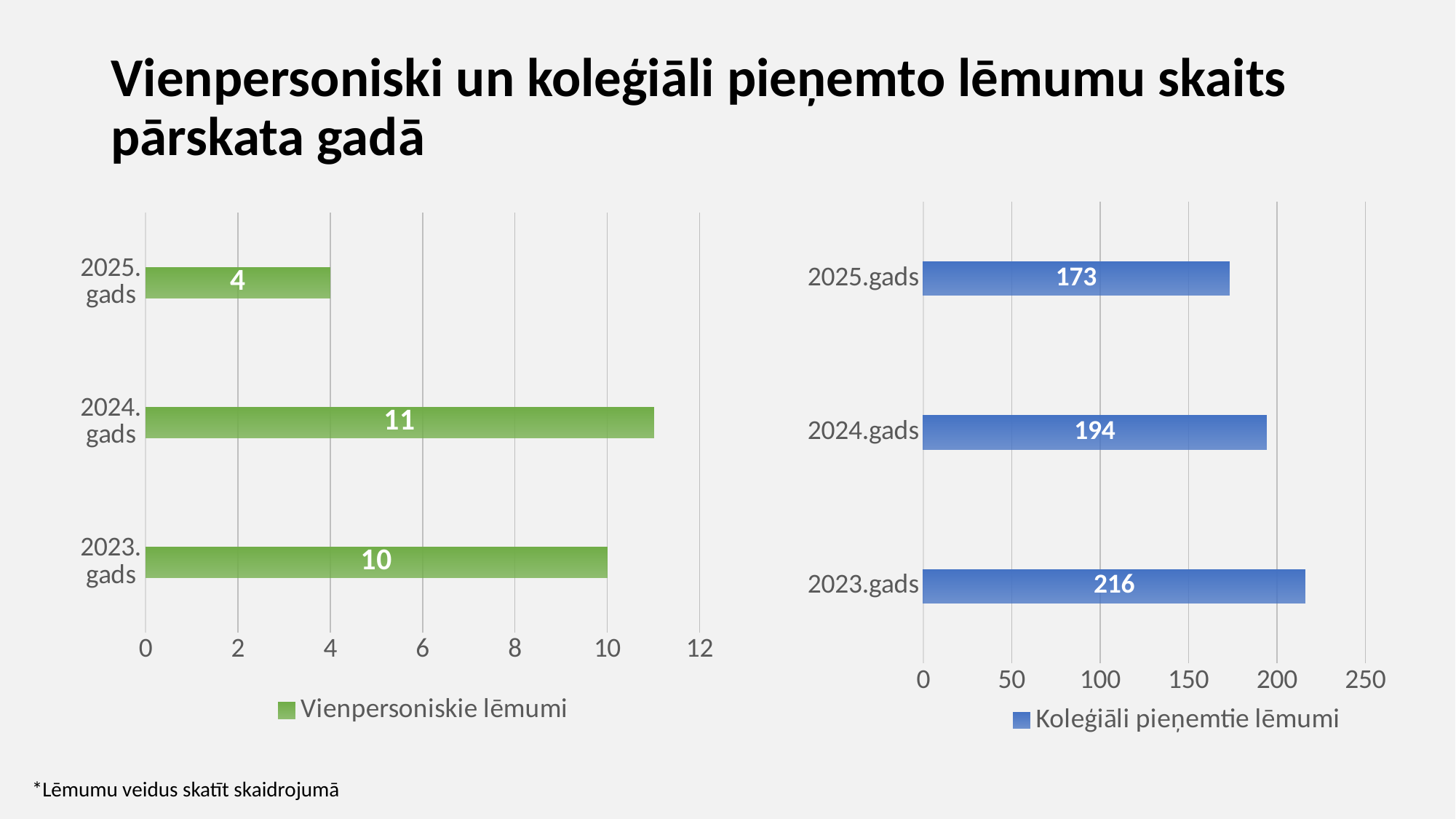
In the right chart (Koleģiāli pieņemtie lēmumi), which year has the lowest value? 2025.gads In the right chart (Koleģiāli pieņemtie lēmumi), is the value for 2024.gads greater or less than 150? greater In the left chart (Vienpersoniskie lēmumi), what is the value for 2024. gads? 11 In the left chart (Vienpersoniskie lēmumi), which year has the highest value? 2024. gads In the right chart (Koleģiāli pieņemtie lēmumi), what is the value for 2025.gads? 173 In the left chart (Vienpersoniskie lēmumi), what is the difference between the values for 2024. gads and 2025. gads? 7 In the right chart (Koleģiāli pieņemtie lēmumi), what is the value for 2023.gads? 216 In the right chart (Koleģiāli pieņemtie lēmumi), which is larger: the value for 2024.gads or 2025.gads? 2024.gads In the right chart (Koleģiāli pieņemtie lēmumi), what is the difference between the values for 2023.gads and 2024.gads? 22 How many years are shown in the left chart (Vienpersoniskie lēmumi)? 3 What kind of chart is the right chart (Koleģiāli pieņemtie lēmumi)? bar chart In the left chart (Vienpersoniskie lēmumi), what is the value for 2025. gads? 4